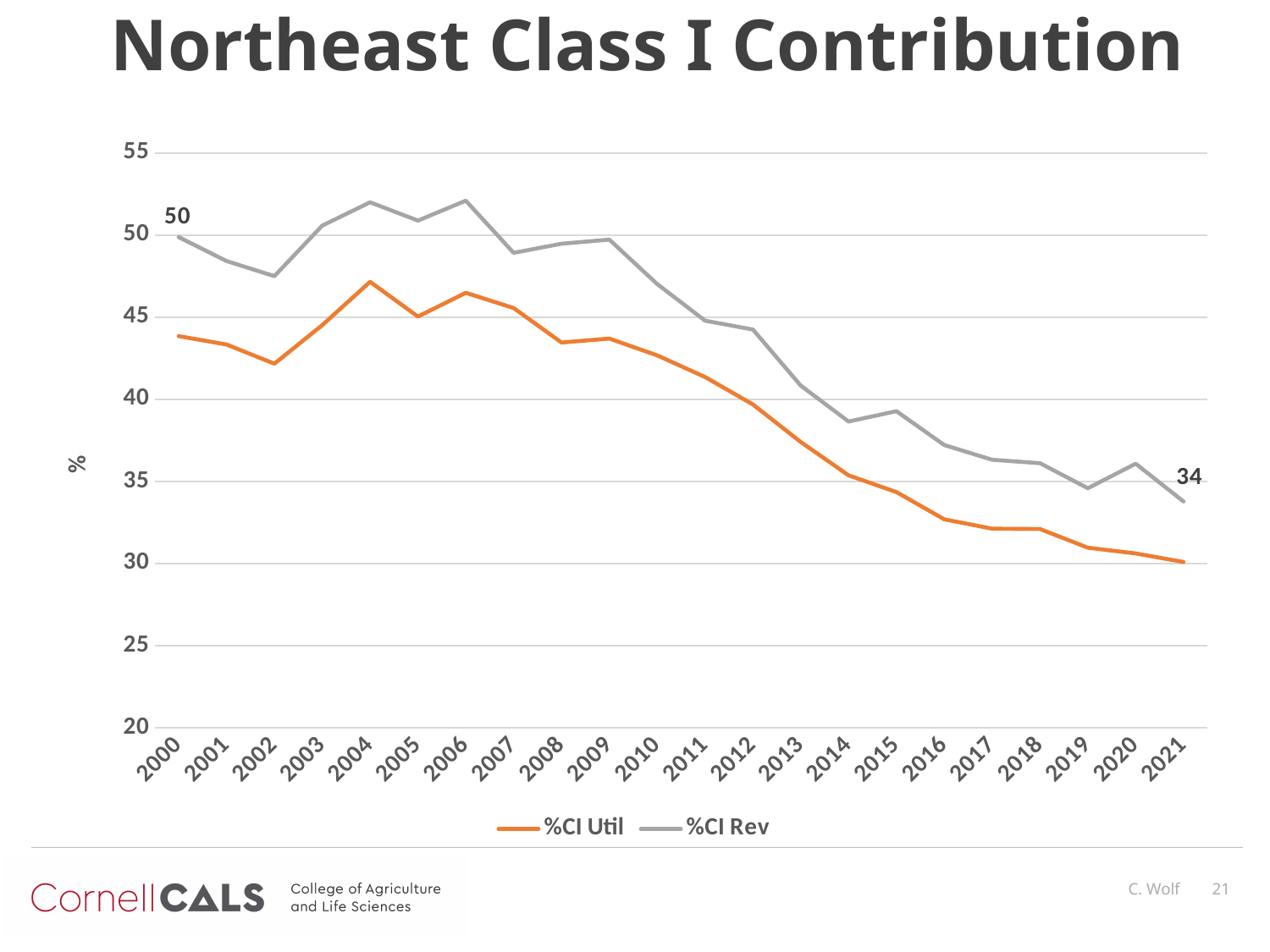
Which series is drawn in orange? %CI Util By how much did %CI Rev fall from 2000 to 2021? 16 Do the values of %CI Util generally rise or fall from 2000 to 2021? Fall How many years are shown on the x axis? 22 What is the value of %CI Rev in 2000? 50 Is the value for %CI Rev in 2004 greater or less than 50? greater What kind of chart is shown on the slide? Line chart In 2010, which series is higher, %CI Util or %CI Rev? %CI Rev Is the value for %CI Util in 2021 greater or less than 35? less Is the value for %CI Rev in 2012 greater or less than 40? greater What is the value of %CI Rev in 2021? 34 How many series does the legend list? 2